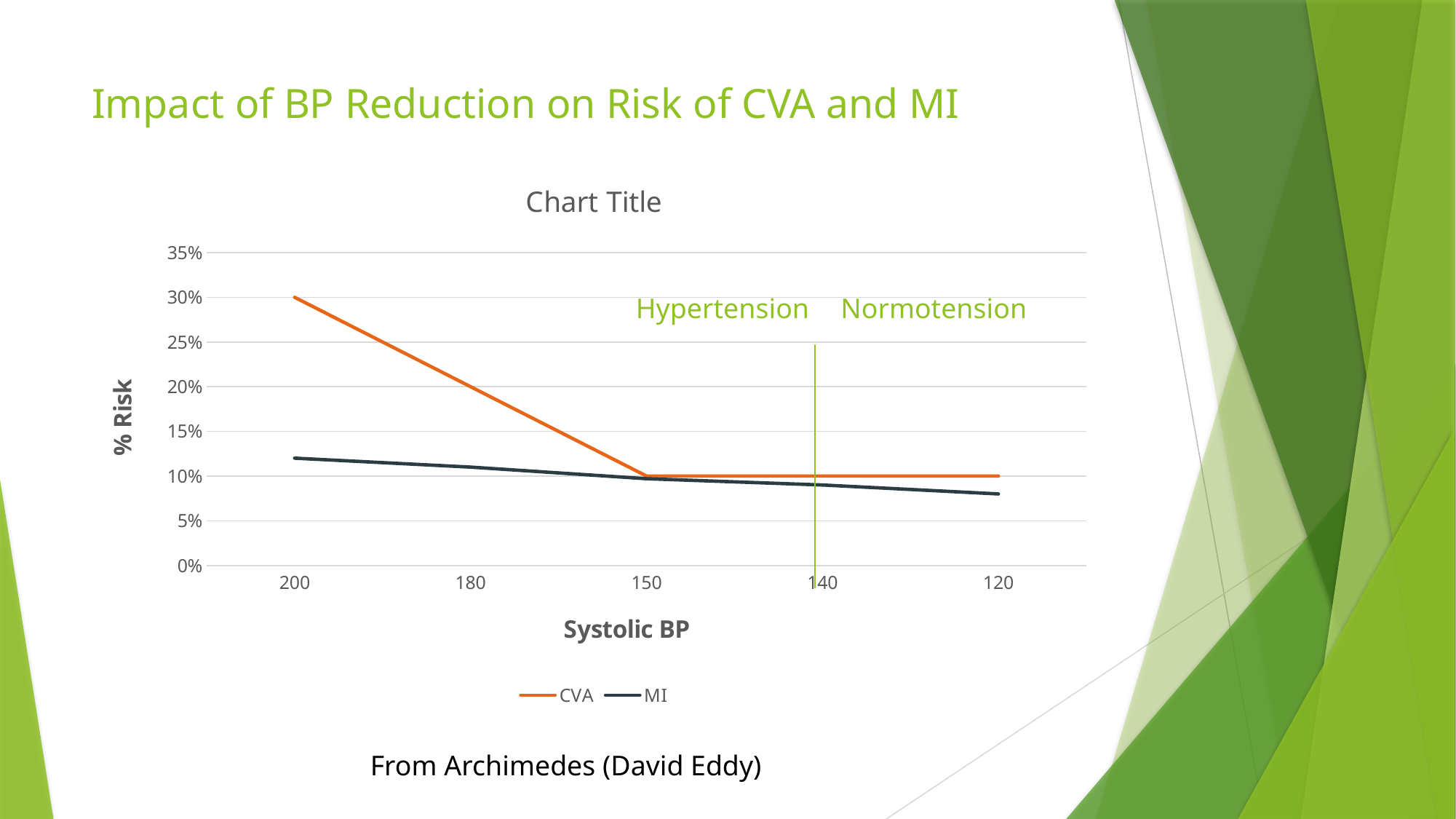
How many systolic BP values are shown along the x axis? 5 What is the CVA risk at a systolic BP of 150? 10% At a systolic BP of 200, which series has the higher risk, CVA or MI? CVA Is the MI risk at a systolic BP of 120 greater or less than 10%? less At which systolic BP value is the CVA risk highest? 200 Is the MI risk at a systolic BP of 200 greater or less than 15%? less What is the label on the y axis? % Risk What is the CVA risk at a systolic BP of 120? 10% What is the difference between the CVA risk at systolic BP 200 and at systolic BP 120? 20% What kind of chart is shown on the slide? line chart How many series does the legend list? 2 What is the CVA risk at a systolic BP of 200? 30%